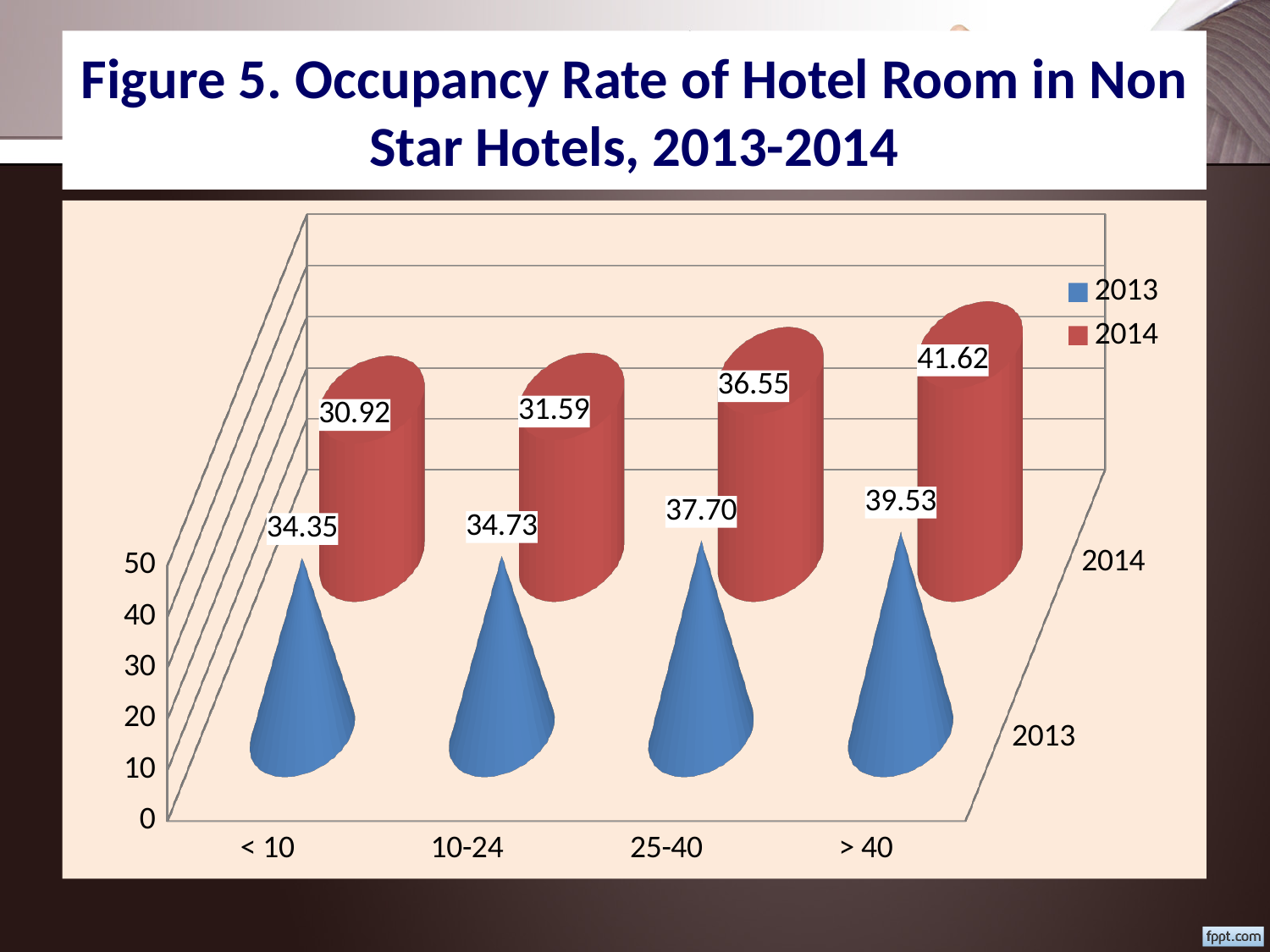
How many hotel size categories are shown on the x axis? 4 What is the 2014 value for the 10-24 category? 31.59 For the 25-40 category, which year has the larger occupancy rate, 2013 or 2014? 2013 Which colour represents the 2013 series in the legend? Blue What is the difference between the 2014 and 2013 values for the > 40 category? 2.09 Which category has the lowest occupancy rate in 2013? < 10 What is the 2013 value for the 25-40 category? 37.70 Do the 2014 values rise or fall from the < 10 category to the > 40 category? rise What is the occupancy rate for the > 40 category in 2014? 41.62 How many series does the legend list? 2 Which category has the highest occupancy rate in 2014? > 40 What is the occupancy rate for the < 10 category in 2013? 34.35